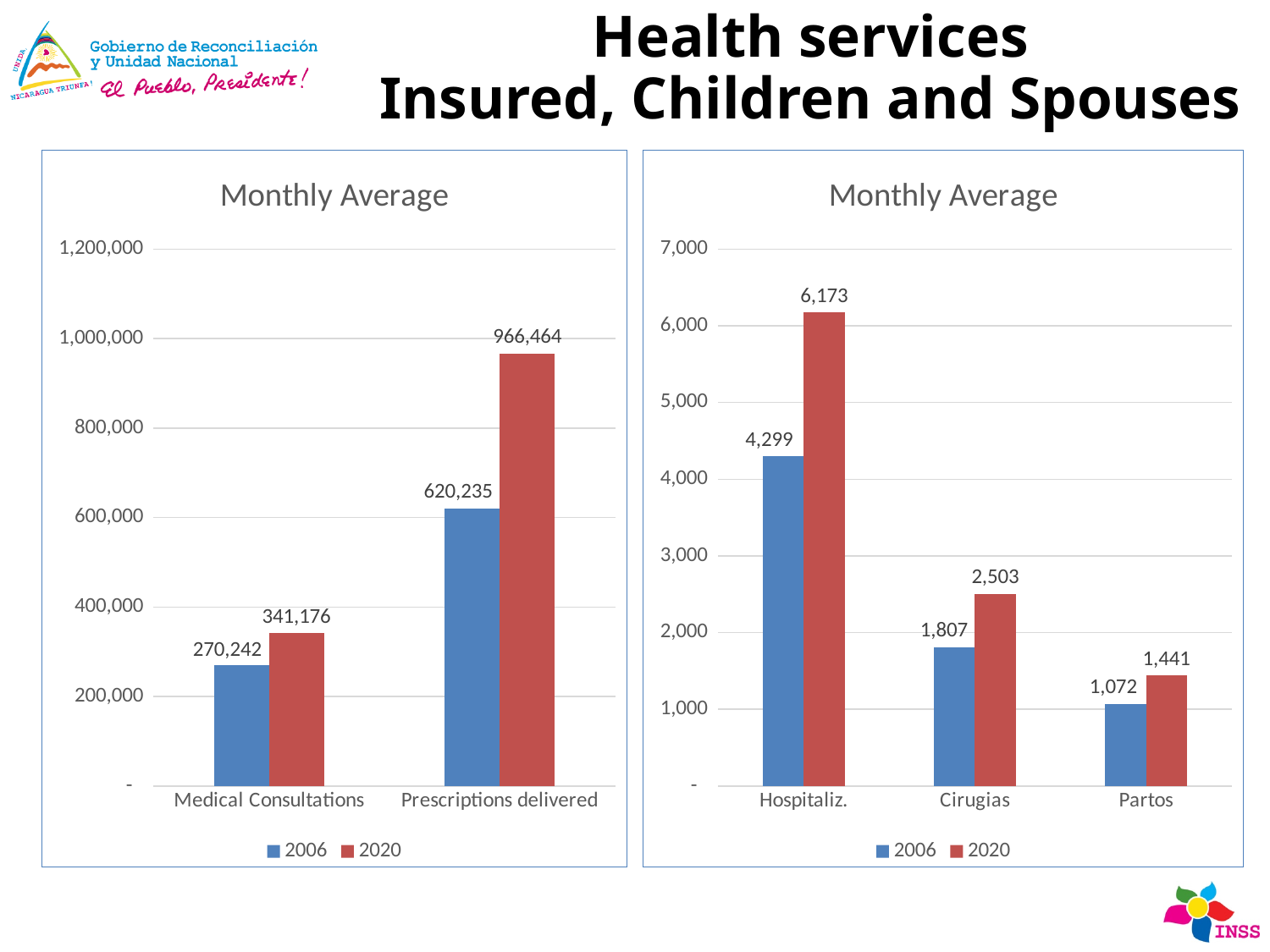
In the left chart, what is the 2020 value for Prescriptions delivered? 966,464 In the right chart, what is the difference between the 2020 and 2006 values for Cirugias? 696 In the left chart, what is the difference between the 2020 and 2006 values for Prescriptions delivered? 346,229 What type of chart is the right chart? Bar chart How many series does the legend of the left chart list? 2 In the left chart, what is the 2006 value for Medical Consultations? 270,242 In the right chart, which category has the lowest 2006 value? Partos How many categories are shown on the x axis of the right chart? 3 In the right chart, which category has the highest 2020 value? Hospitaliz. In the right chart, what is the 2020 value for Hospitaliz.? 6,173 In the left chart, which is larger: the 2020 value for Medical Consultations or the 2006 value for Prescriptions delivered? 2006 value for Prescriptions delivered In the right chart, what is the 2006 value for Partos? 1,072